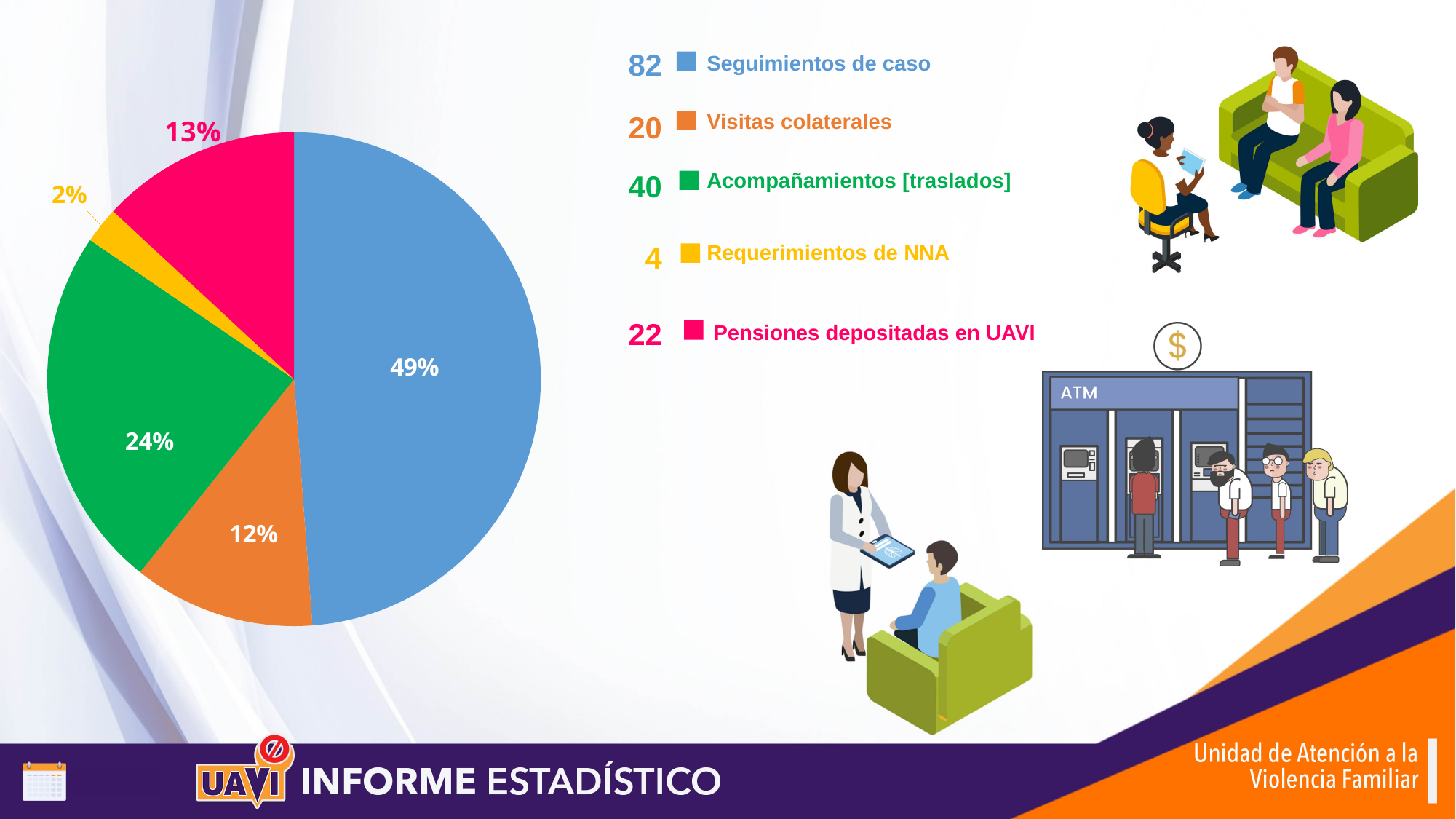
What percentage share does the Pensiones depositadas en UAVI slice have in the pie chart? 13% Which category has the largest slice in the pie chart? Seguimientos de caso What is the difference in percentage points between the Seguimientos de caso slice and the Acompañamientos [traslados] slice? 25 What percentage share does the Seguimientos de caso slice have in the pie chart? 49% How many slices does the pie chart have? 5 What percentage share does the Acompañamientos [traslados] slice have in the pie chart? 24% What kind of chart is shown on the slide? pie chart Which is larger in the pie chart, the Visitas colaterales slice or the Pensiones depositadas en UAVI slice? Pensiones depositadas en UAVI What count is listed in the legend for Visitas colaterales? 20 Which category has the smallest slice in the pie chart? Requerimientos de NNA What count is listed in the legend for Acompañamientos [traslados]? 40